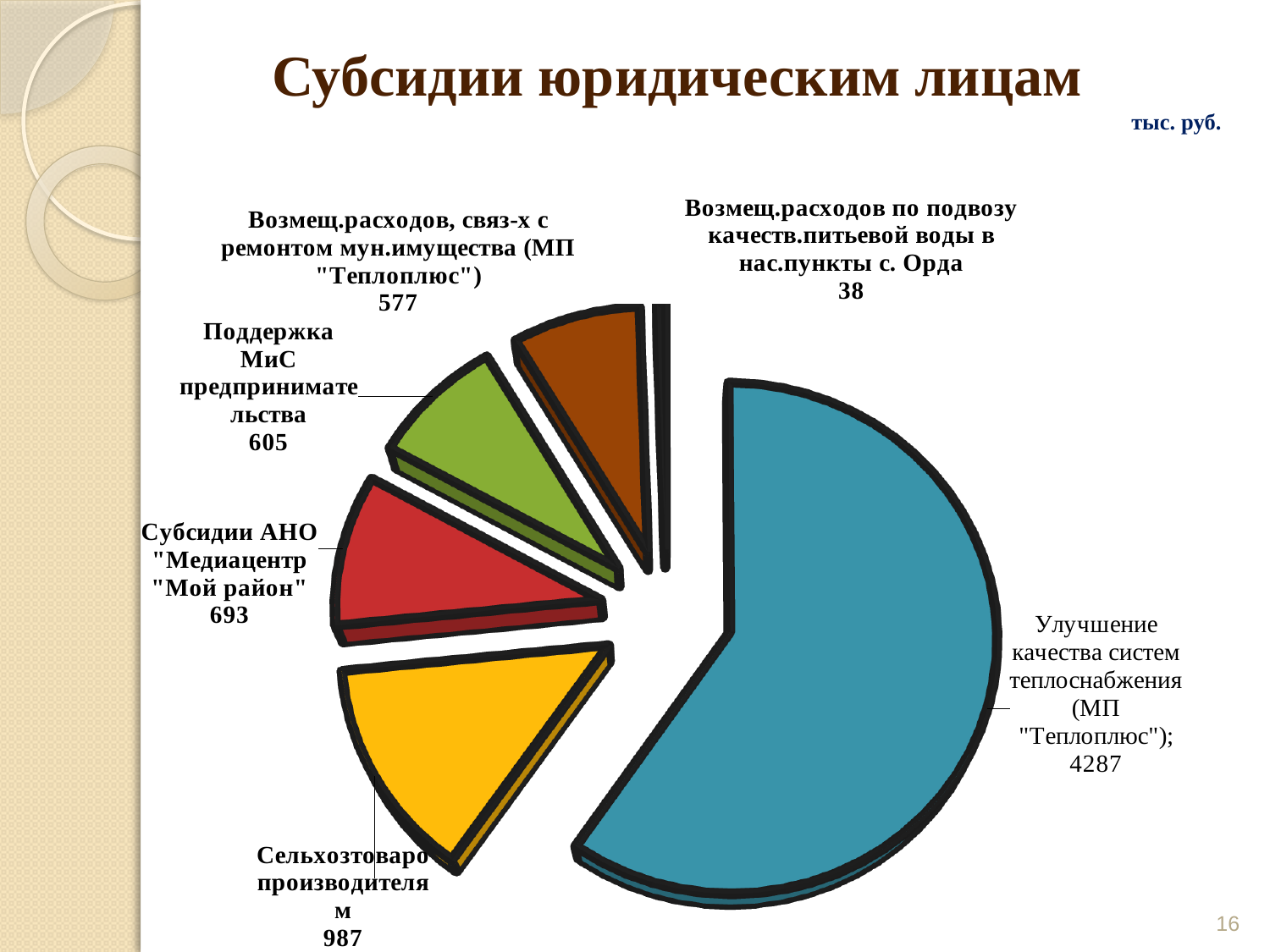
Which category has the largest value? Улучшение качества систем теплоснабжения (МП "Теплоплюс") In what units are the values on the chart given? тыс. руб. What kind of chart is shown on the slide? pie chart How many slices does the pie chart have? 6 Which is larger: Субсидии АНО "Медиацентр "Мой район" or Поддержка МиС предпринимательства? Субсидии АНО "Медиацентр "Мой район" What is the value for Улучшение качества систем теплоснабжения (МП "Теплоплюс")? 4287 What is the value for Возмещ.расходов по подвозу качеств.питьевой воды в нас.пункты с. Орда? 38 What is the value for Сельхозтоваропроизводителям? 987 Which category has the smallest value? Возмещ.расходов по подвозу качеств.питьевой воды в нас.пункты с. Орда What is the total of all the values shown on the pie chart? 7187 What is the title of the chart? Субсидии юридическим лицам What is the difference between the values for Сельхозтоваропроизводителям and Субсидии АНО "Медиацентр "Мой район"? 294